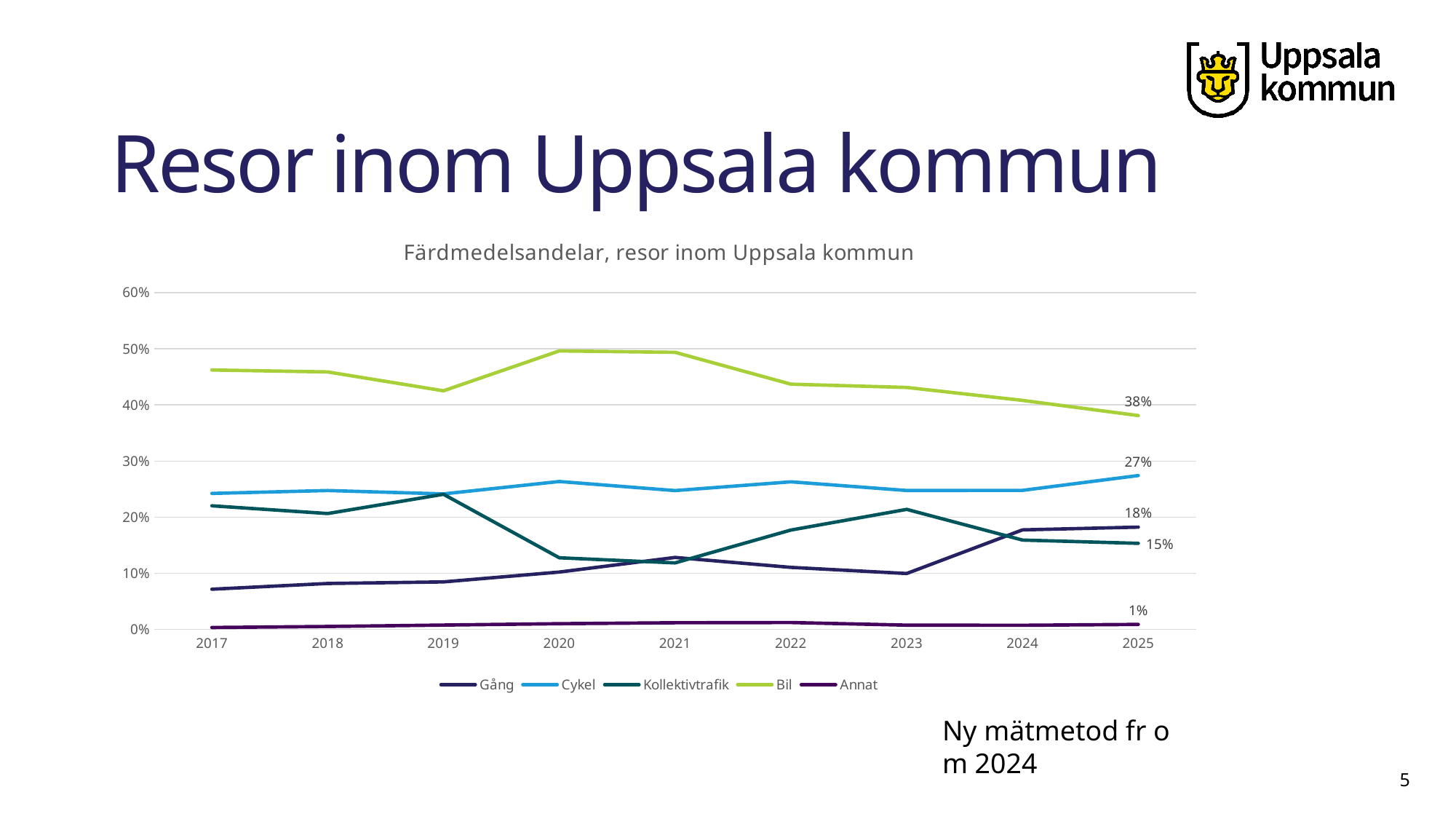
What is the value for Annat in 2025? 1% What is the value for Kollektivtrafik in 2025? 15% What is the value for Gång in 2025? 18% How many series does the legend of the chart list? 5 What is the difference between the values for Bil and Cykel in 2025? 11 percentage points How many years are plotted along the x axis of the chart? 9 Which series has the highest value in 2025? Bil Is the value for Bil in 2020 greater or less than 40%? greater Does the Bil line rise or fall from 2020 to 2025? Fall What kind of chart is shown on the slide? Line chart What is the value for Cykel in 2025? 27% What is the value for Bil in 2025? 38%